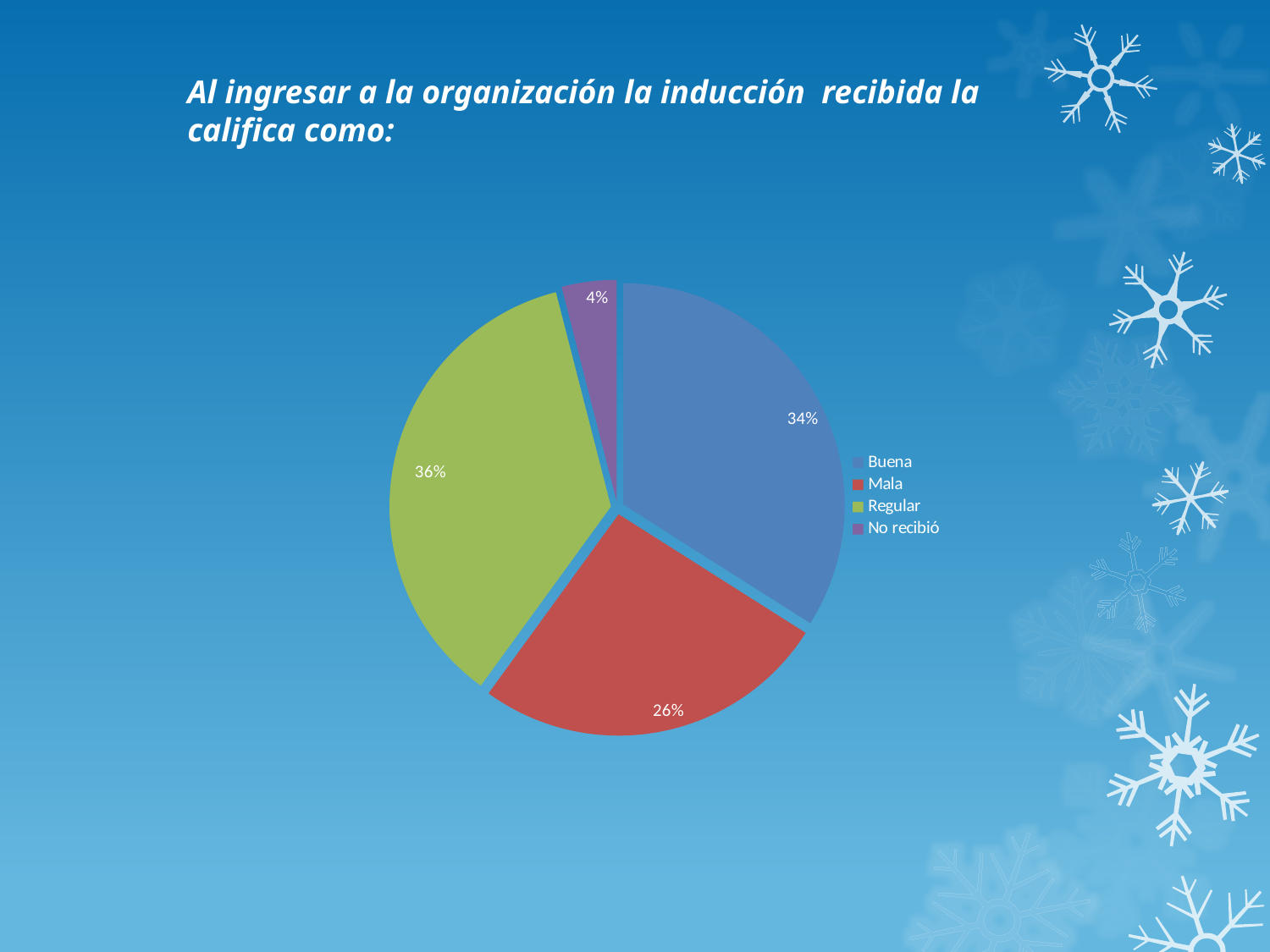
How many categories does the pie chart show? 4 What percentage of the pie does the Buena slice represent? 34% What percentage of the pie does the No recibió slice represent? 4% What type of chart is shown on the slide? pie chart Which slice is larger, Buena or Mala? Buena Which colour represents the Mala category in the legend? red What is the difference in percentage points between the Buena and No recibió slices? 30 What percentage of the pie does the Regular slice represent? 36% Which category has the largest share of the pie? Regular What is the difference in percentage points between the Regular and Mala slices? 10 What percentage of the pie does the Mala slice represent? 26% Which category has the smallest share of the pie? No recibió